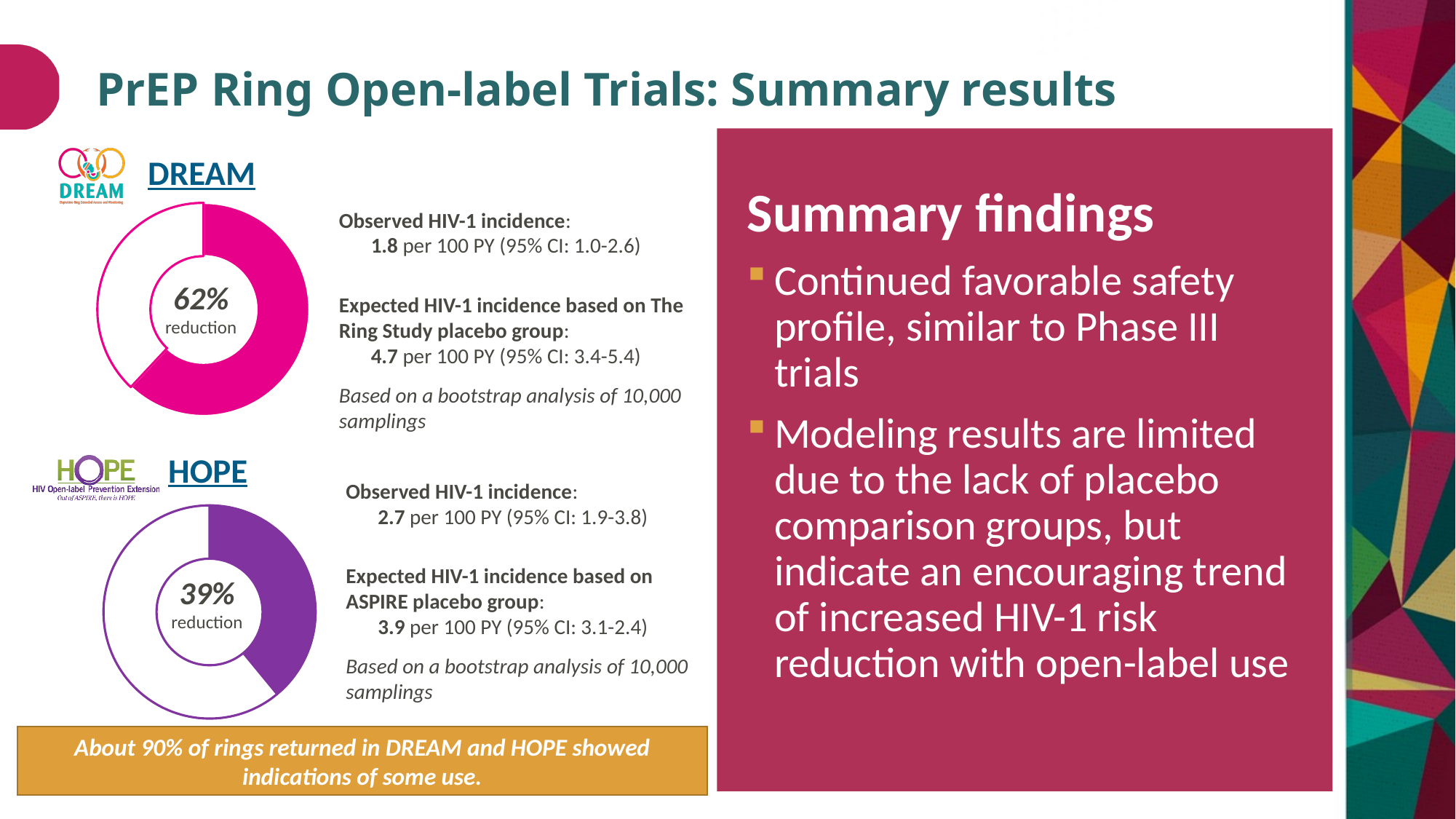
What colour is the filled segment of the HOPE donut chart? Purple How many donut charts are shown on the slide? 2 What percentage reduction is shown in the center of the DREAM donut chart? 62% What colour is the filled segment of the DREAM donut chart? Pink (magenta) Is the reduction shown in the DREAM donut chart greater or less than 50%? greater Which trial's donut chart shows the larger reduction, DREAM or HOPE? DREAM What kind of chart is used to show the reduction for DREAM and HOPE? Donut (pie) chart Which trial's donut chart shows the smaller reduction, DREAM or HOPE? HOPE What is the difference in percentage points between the reduction shown in the DREAM chart and the reduction shown in the HOPE chart? 23 percentage points What percentage reduction is shown in the center of the HOPE donut chart? 39% Is the reduction shown in the HOPE donut chart greater or less than 50%? less What share of the HOPE donut chart is filled in purple? 39%